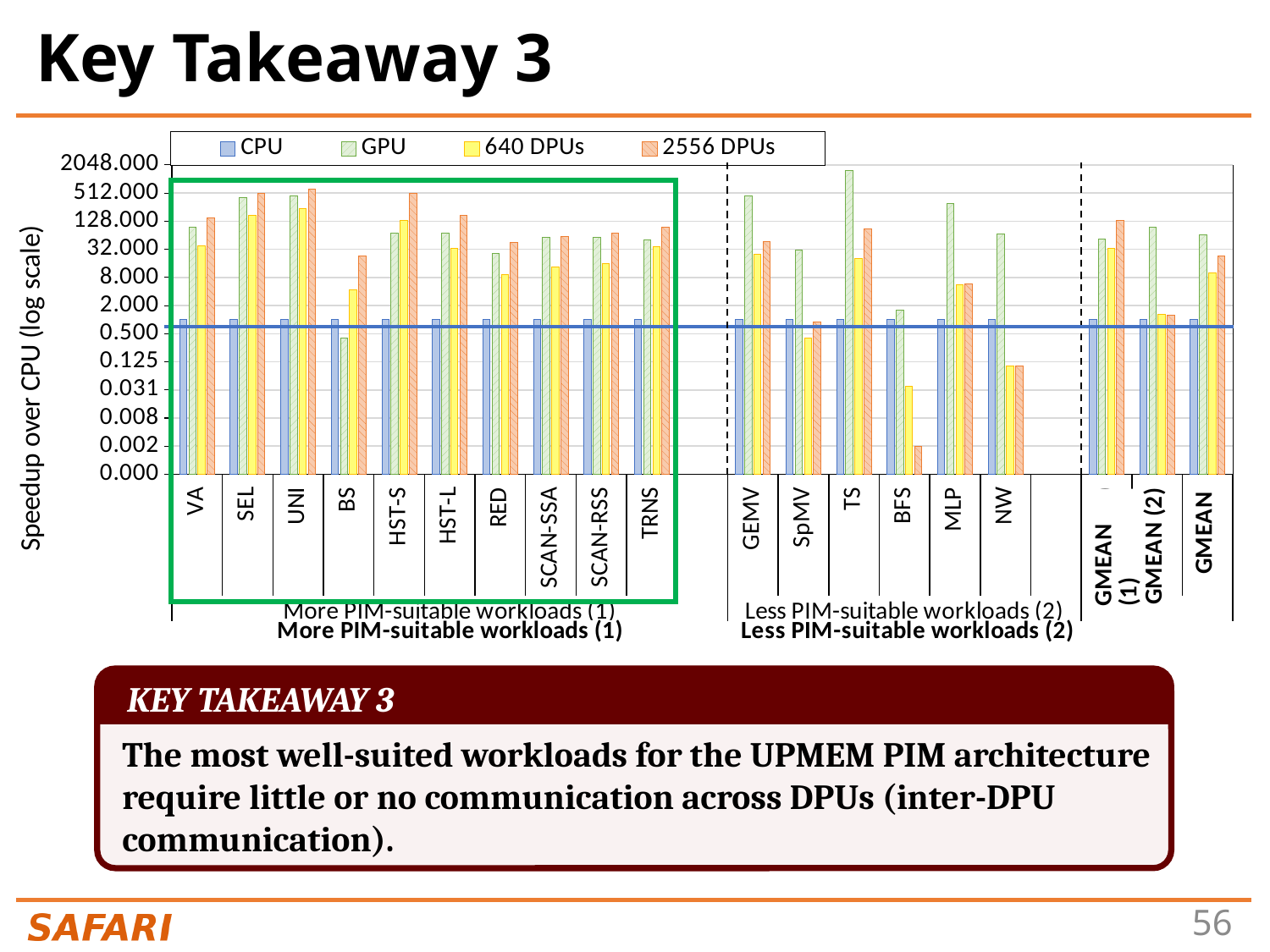
For BS, which is larger: the GPU value or the 2556 DPUs value? 2556 DPUs Is the GPU value for MLP greater or less than 128.000? greater What kind of chart is shown on the slide? bar chart Which workload has the lowest 2556 DPUs bar? BFS Is the 640 DPUs value for NW greater or less than 0.500? less Is the GPU value for TS greater or less than 512.000? greater Which workload has the highest GPU bar? TS For GMEAN (2), which is larger: the GPU value or the 2556 DPUs value? GPU How many series does the legend list? 4 Which series are listed in the legend? CPU, GPU, 640 DPUs, 2556 DPUs What is the title of the y axis? Speedup over CPU (log scale)